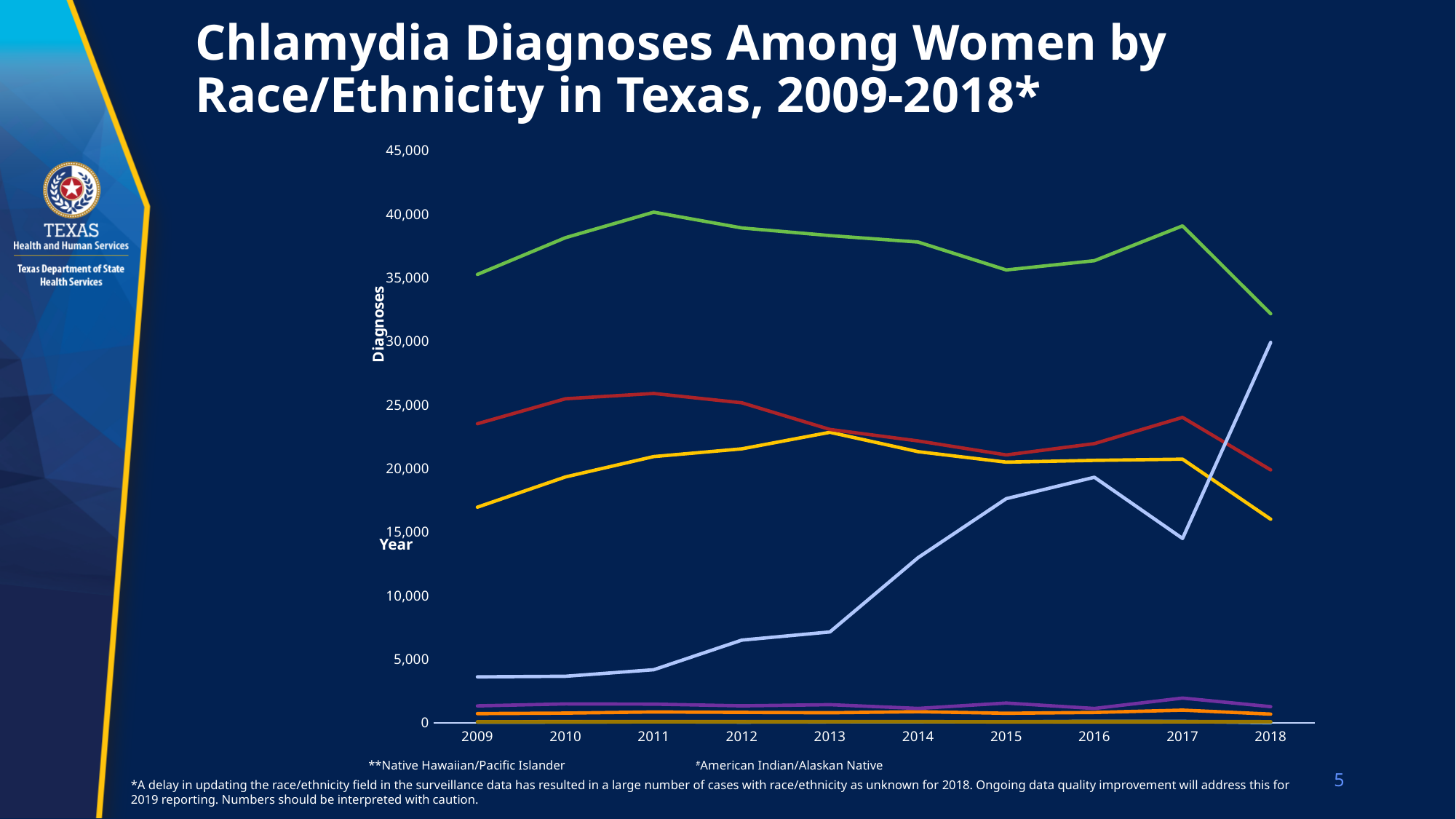
Does the light blue line rise or fall between 2013 and 2018? rise What is the highest value shown on the vertical axis of the chart? 45,000 What kind of chart is shown on the slide? line chart Does the green line rise or fall between 2017 and 2018? fall What is the last year shown on the x axis? 2018 Is the value of the red line in 2018 greater or less than 25,000? less Is the value of the light blue line in 2009 greater or less than 5,000? less What is the label of the vertical axis of the chart? Diagnoses Is the value of the green line in 2011 greater or less than 35,000? greater How many years are shown along the x axis of the chart? 10 What is the title of the chart on the slide? Chlamydia Diagnoses Among Women by Race/Ethnicity in Texas, 2009-2018* What is the first year shown on the x axis? 2009